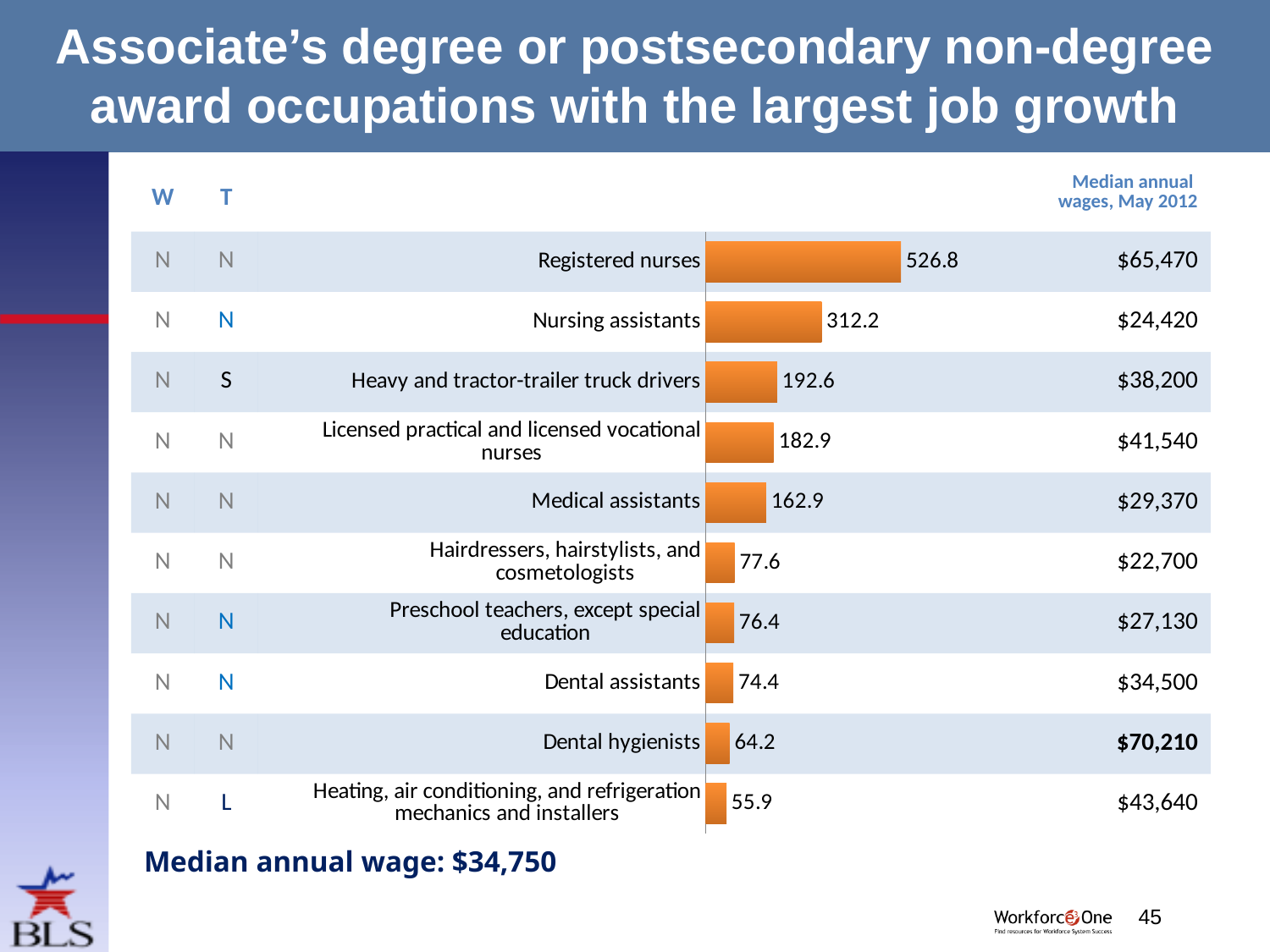
Which has a larger value, Dental assistants or Dental hygienists? Dental assistants Which occupation has the highest value in the chart? Registered nurses What is the value shown for Registered nurses? 526.8 Which has a larger value, Nursing assistants or Medical assistants? Nursing assistants What is the difference between the values for Heavy and tractor-trailer truck drivers and Licensed practical and licensed vocational nurses? 9.7 What is the value shown for Medical assistants? 162.9 How many occupations are shown in the chart? 10 What kind of chart is shown on the slide? Bar chart What is the difference between the values for Registered nurses and Nursing assistants? 214.6 What is the median annual wage (May 2012) listed for Dental hygienists? $70,210 Which occupation has the lowest value in the chart? Heating, air conditioning, and refrigeration mechanics and installers What is the value shown for Heating, air conditioning, and refrigeration mechanics and installers? 55.9